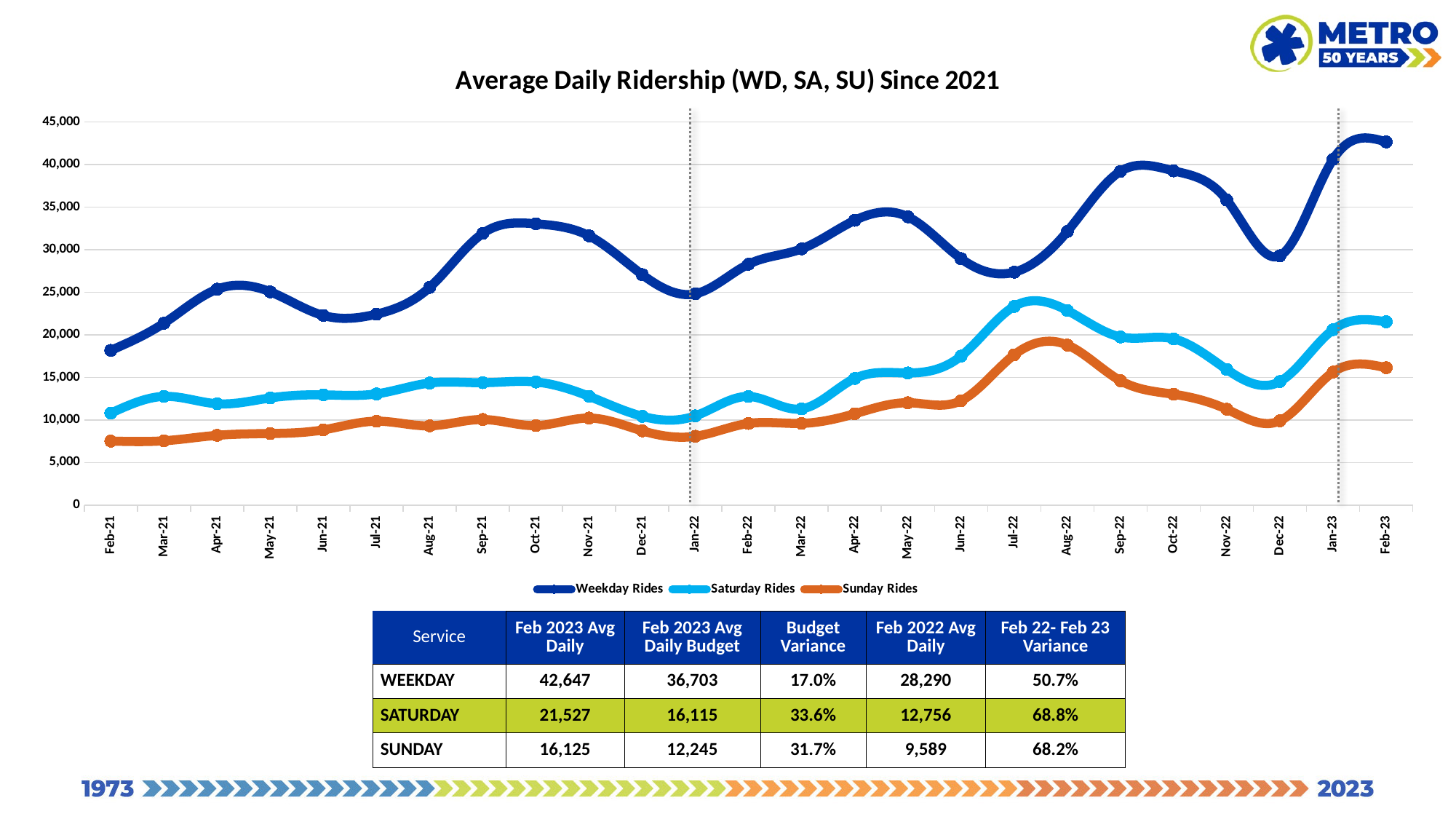
According to the table, what was the Feb 2022 average daily Sunday ridership? 9,589 Is the value for Weekday Rides in Dec-22 greater or less than 30,000? less In which month is the Weekday Rides line at its lowest? Feb-21 How many monthly points are plotted along the x axis of the chart? 25 Is the value for Sunday Rides in Aug-22 greater or less than 15,000? greater Using the table values, what is the difference between Feb 2023 average daily Weekday and Saturday ridership? 21,120 What kind of chart is shown on the slide? Line chart According to the table, what was the Feb 2023 average daily Weekday ridership? 42,647 In which month does the Saturday Rides line reach its highest point? Jul-22 What is the title of the chart? Average Daily Ridership (WD, SA, SU) Since 2021 Which series is drawn in orange on the chart? Sunday Rides How many series does the chart legend list? 3